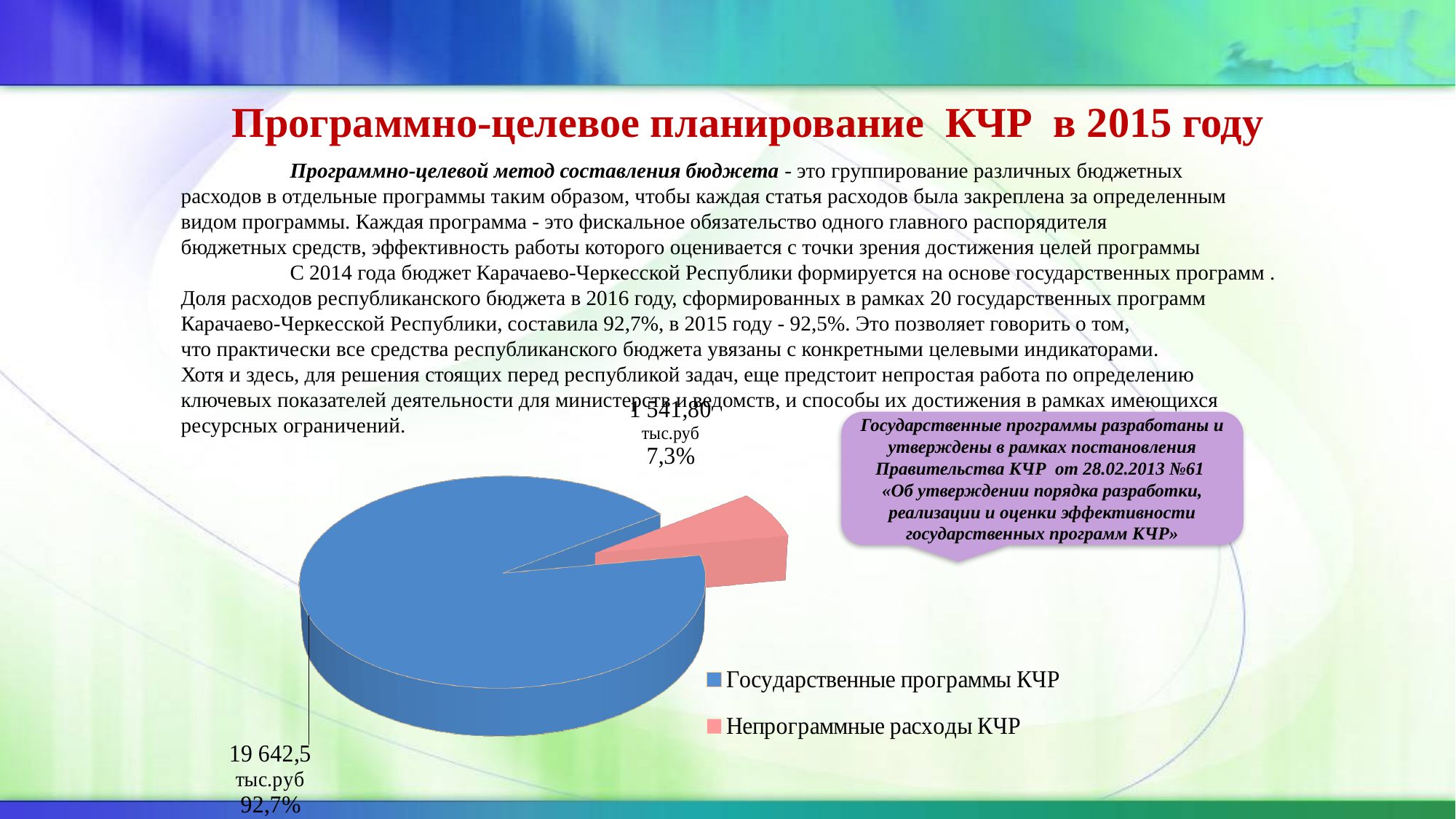
Which slice of the pie chart is the smallest? Непрограммные расходы КЧР What is the difference in тыс.руб between Государственные программы КЧР and Непрограммные расходы КЧР? 18 100,7 тыс.руб What kind of chart is shown on the slide? Pie chart What share of the pie does Государственные программы КЧР represent? 92,7% Which is larger in the pie chart: Государственные программы КЧР or Непрограммные расходы КЧР? Государственные программы КЧР How many entries does the legend of the pie chart list? 2 Which slice of the pie chart is the largest? Государственные программы КЧР How many slices does the pie chart have? 2 What share of the pie does Непрограммные расходы КЧР represent? 7,3% What is the value for Государственные программы КЧР in the pie chart? 19 642,5 тыс.руб What colour is the slice for Непрограммные расходы КЧР in the pie chart? Pink (light red) What is the value for Непрограммные расходы КЧР in the pie chart? 1 541,80 тыс.руб